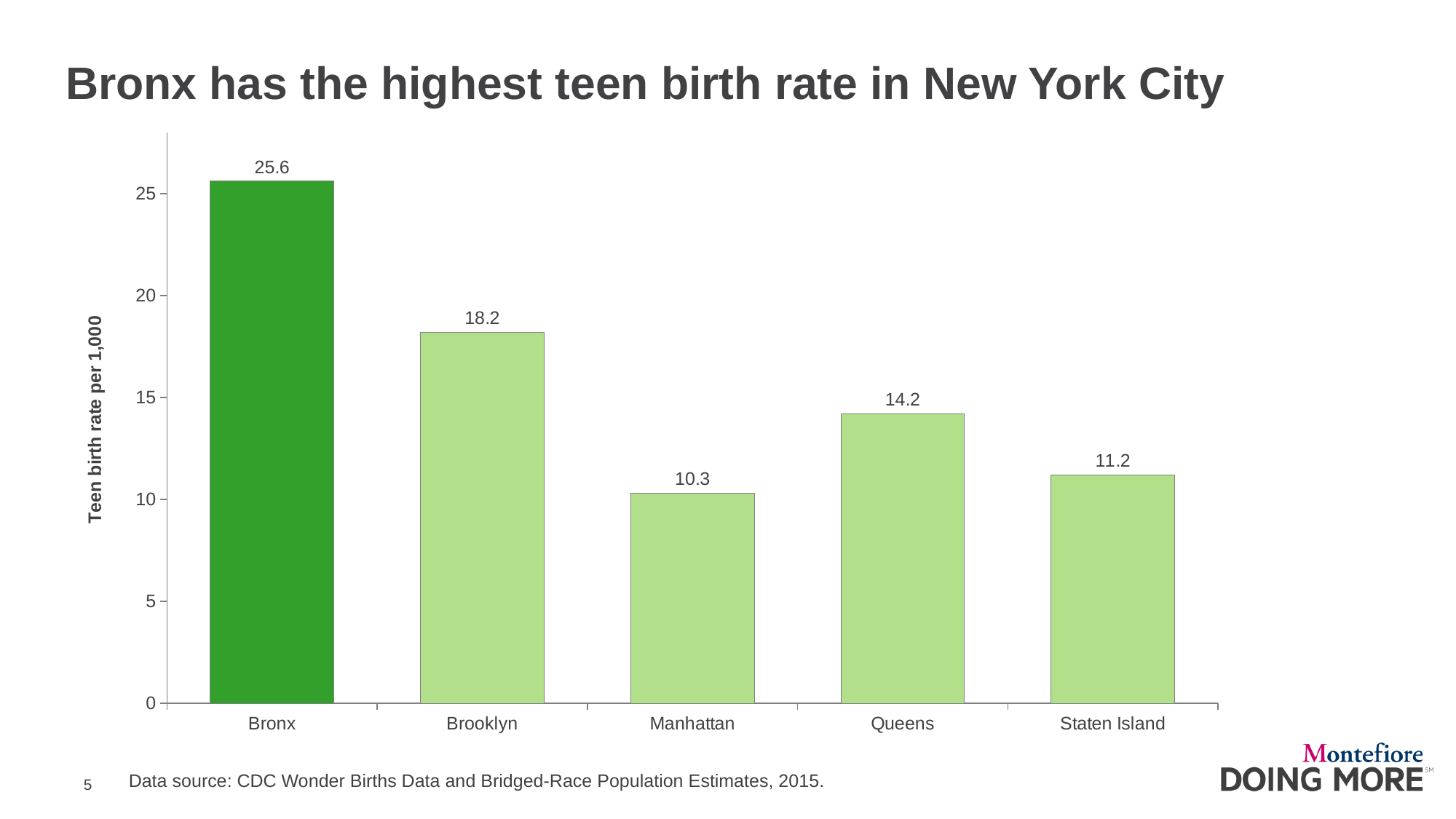
What is the label of the vertical axis? Teen birth rate per 1,000 What is the difference between the teen birth rates of Queens and Manhattan? 3.9 What is the teen birth rate per 1,000 for Brooklyn? 18.2 Which borough has the highest teen birth rate? Bronx What is the teen birth rate per 1,000 for Staten Island? 11.2 What kind of chart is shown on the slide? Bar chart How many boroughs are shown on the chart? 5 Is the teen birth rate for Brooklyn greater or less than 20? less What is the teen birth rate per 1,000 for the Bronx? 25.6 What is the difference between the teen birth rates of the Bronx and Brooklyn? 7.4 Which borough has the lowest teen birth rate? Manhattan Which has a higher teen birth rate, Queens or Staten Island? Queens